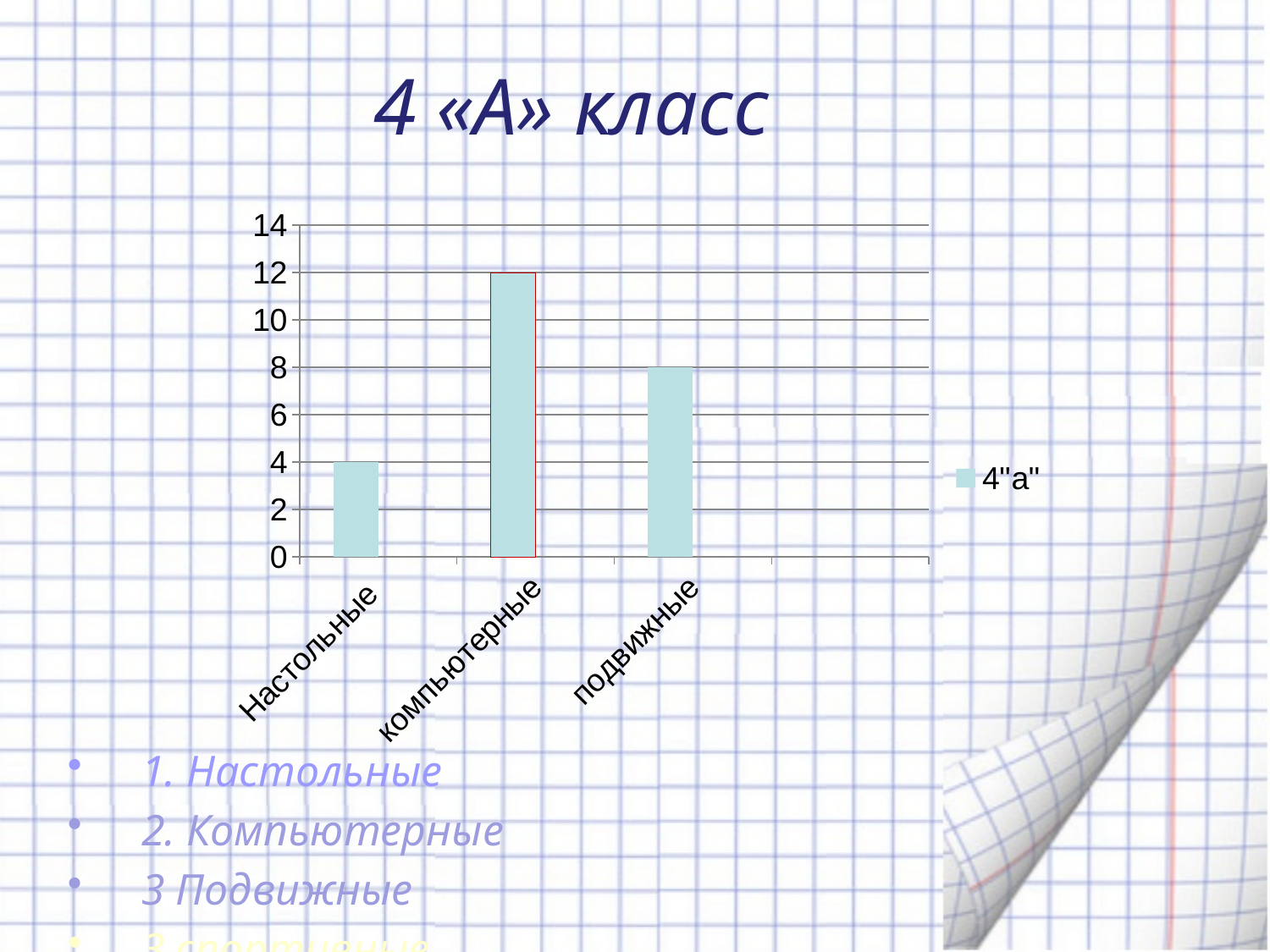
Is the value for компьютерные greater or less than 10? greater What kind of chart is shown on the slide? bar chart Which is larger, the value for подвижные or the value for настольные? подвижные What is the value for настольные? 4 What is the difference between the values for подвижные and настольные? 4 How many categories are shown on the x axis? 3 What is the difference between the values for компьютерные and подвижные? 4 How many series does the legend list? 1 Which category has the lowest value? настольные Which category has the highest value? компьютерные What is the value for подвижные? 8 What is the value for компьютерные? 12